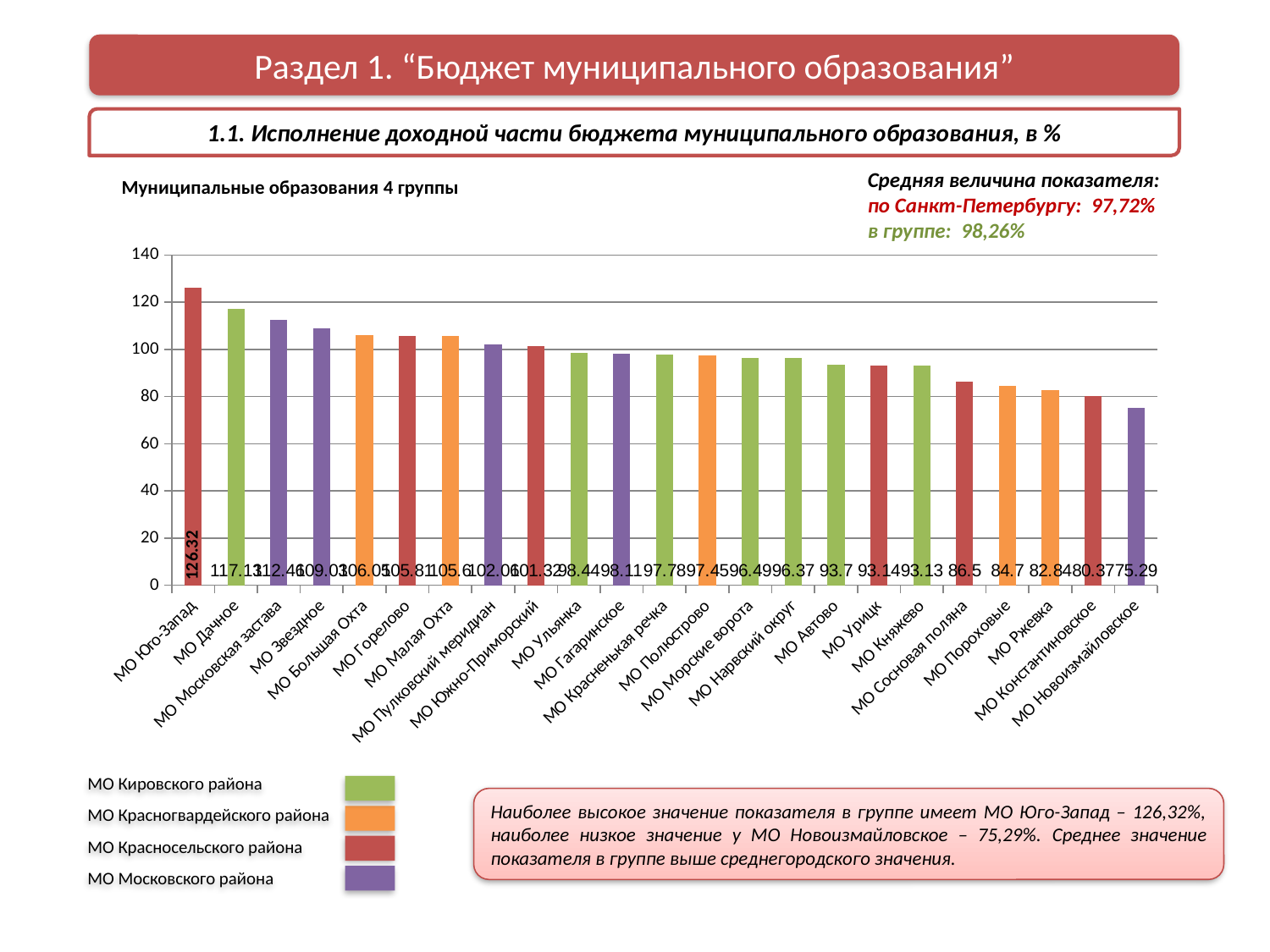
Do the values rise or fall from left to right along the x axis? fall Is the value for МО Дачное greater or less than 100? greater Which has the larger value, МО Автово or МО Пороховые? МО Автово Which municipality has the highest value on the chart? МО Юго-Запад What is the value shown for МО Сосновая поляна? 86.5 What is the value shown for МО Ржевка? 82.84 How many municipalities are shown on the chart? 23 What is the difference between the values for МО Юго-Запад and МО Новоизмайловское? 51.03 What is the value shown for МО Новоизмайловское? 75.29 What kind of chart is shown on the slide? bar chart Which municipality has the lowest value on the chart? МО Новоизмайловское What is the value shown for МО Юго-Запад? 126.32